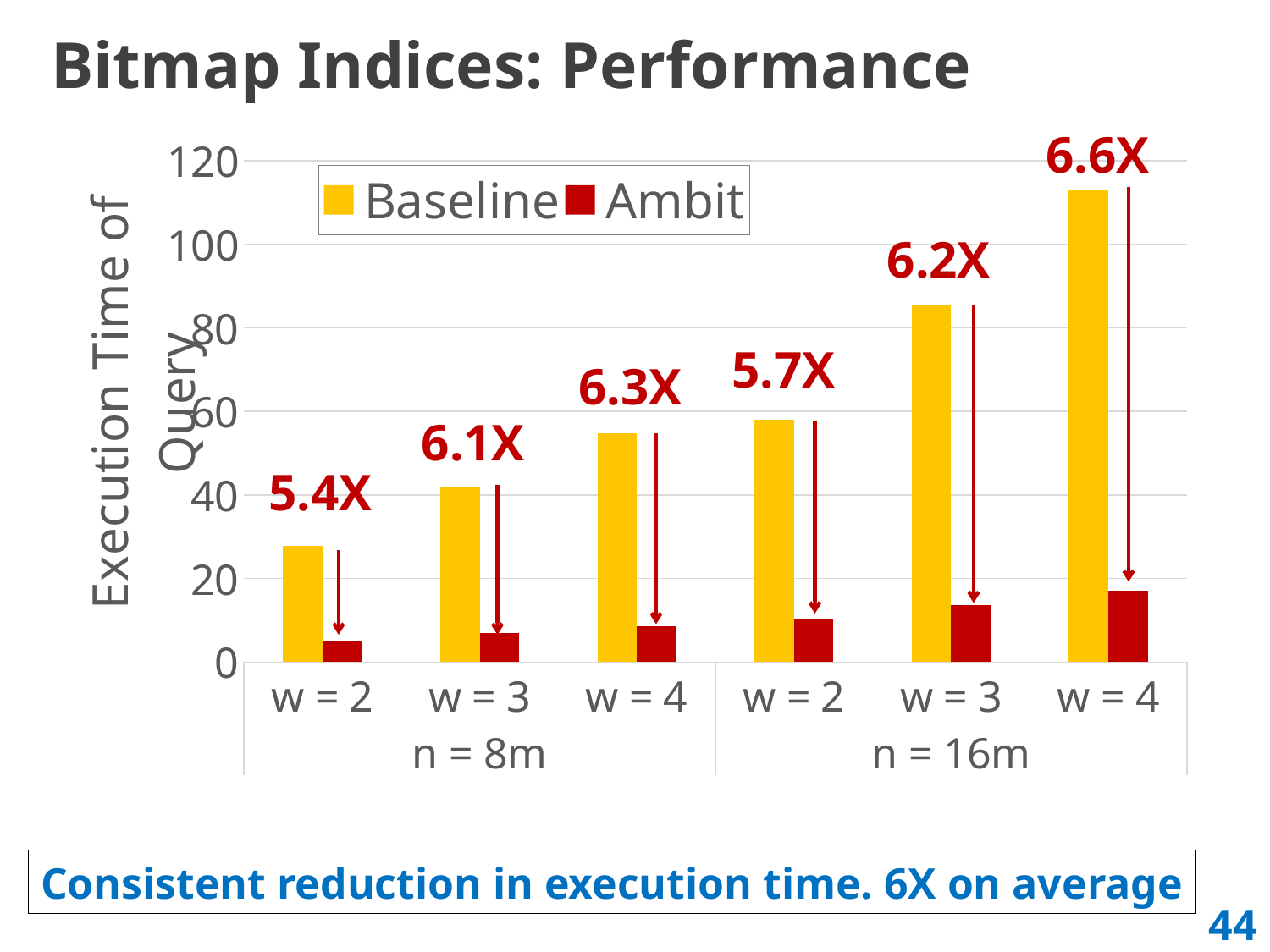
How many series does the legend list? 2 Is the Ambit value for w = 3 under n = 8m greater or less than 20? less What are the two series named in the legend? Baseline and Ambit What speedup label is shown above the bars for w = 4 under n = 16m? 6.6X Which category has the lowest Baseline execution time? w = 2, n = 8m What speedup label is shown above the bars for w = 3 under n = 16m? 6.2X What speedup label is shown above the bars for w = 2 under n = 8m? 5.4X Which is larger, the Baseline value for w = 3 under n = 8m or the Baseline value for w = 2 under n = 16m? w = 2 under n = 16m How many category groups (w values) are plotted along the x axis? 6 Which category has the highest Baseline execution time? w = 4, n = 16m Is the Baseline value for w = 4 under n = 16m greater or less than 100? greater What kind of chart is shown on the slide? bar chart